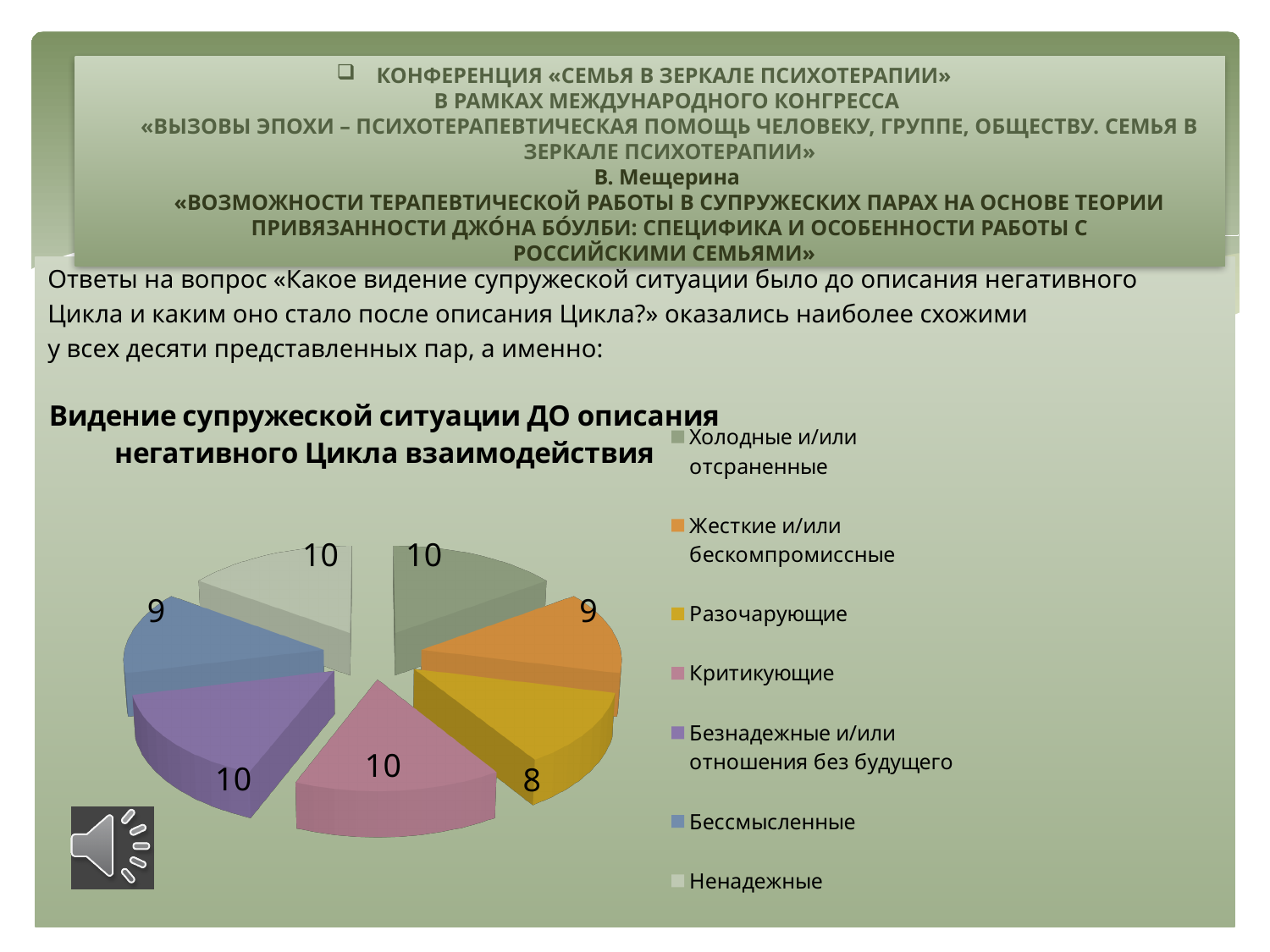
Which category has the lowest value? Разочарующие What is the value for Ненадежные? 10 Which is larger, the value for Безнадежные и/или отношения без будущего or the value for Разочарующие? Безнадежные и/или отношения без будущего What is the difference between the values for Холодные и/или отсраненные and Разочарующие? 2 What kind of chart is shown on the slide? pie chart What is the title of the pie chart? Видение супружеской ситуации ДО описания негативного Цикла взаимодействия What is the value for Критикующие? 10 What is the value for Бессмысленные? 9 How many categories does the pie chart have? 7 What is the value for Разочарующие? 8 What is the total of all the slices in the pie chart? 66 What is the value for Жесткие и/или бескомпромиссные? 9